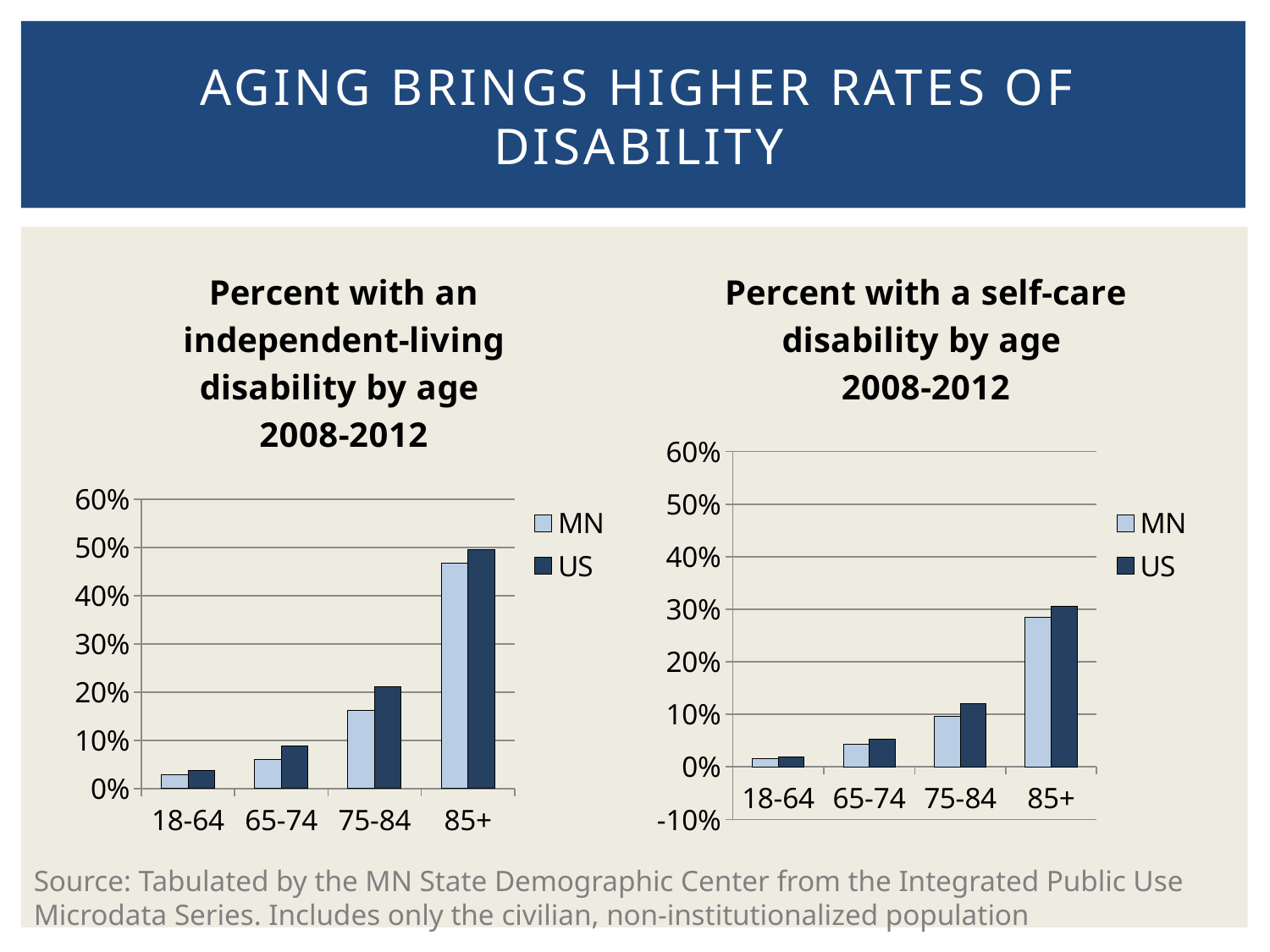
In the chart titled 'Percent with a self-care disability by age 2008-2012', which age group has the highest value for US? 85+ How many age groups are shown on the x axis of the chart titled 'Percent with a self-care disability by age 2008-2012'? 4 In the chart titled 'Percent with an independent-living disability by age 2008-2012', is the US value for 75-84 greater or less than 10%? greater What kind of chart is the chart titled 'Percent with a self-care disability by age 2008-2012'? bar chart How many series does the legend list in the chart titled 'Percent with an independent-living disability by age 2008-2012'? 2 In the chart titled 'Percent with a self-care disability by age 2008-2012', do the MN values rise or fall as age increases along the x axis? rise In the chart titled 'Percent with an independent-living disability by age 2008-2012', for the 75-84 age group, which is larger, MN or US? US In the chart titled 'Percent with an independent-living disability by age 2008-2012', which age group has the lowest value for US? 18-64 In the chart titled 'Percent with a self-care disability by age 2008-2012', is the US value for 85+ greater or less than 20%? greater In the chart titled 'Percent with an independent-living disability by age 2008-2012', is the MN value for 85+ greater or less than 40%? greater In the chart titled 'Percent with an independent-living disability by age 2008-2012', which age group has the highest value for MN? 85+